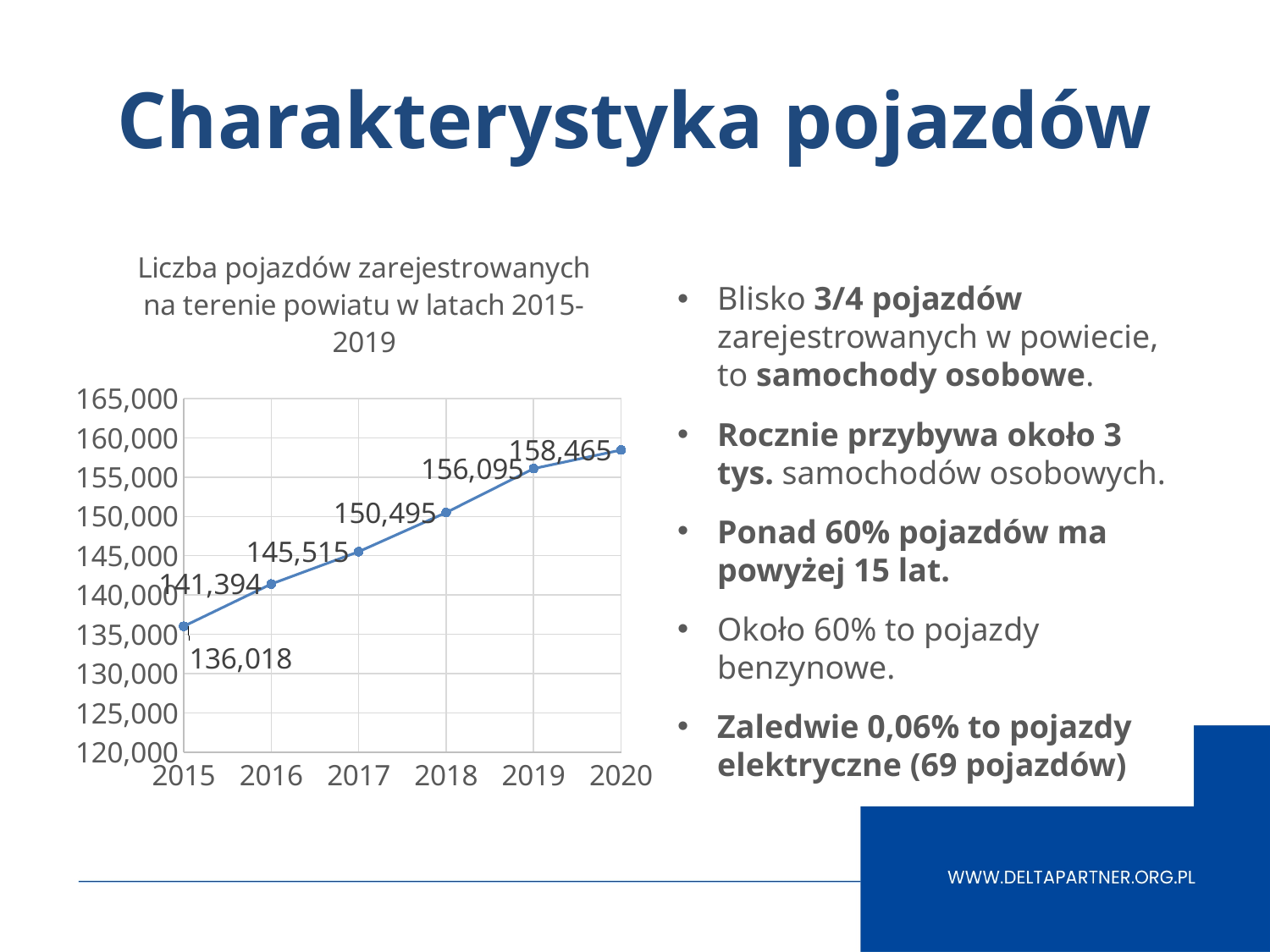
What is the difference between the values for 2020 and 2015? 22,447 Which year has the highest value in the chart? 2020 What is the value for 2018 in the chart? 150,495 Do the values rise or fall from 2015 to 2020? rise What is the value for 2015 in the chart? 136,018 What is the value for 2020 in the chart? 158,465 What kind of chart is shown on the slide? line chart Which is larger, the value for 2017 or the value for 2016? 2017 What is the difference between the values for 2019 and 2018? 5,600 Which year has the lowest value in the chart? 2015 Is the value for 2019 greater or less than 155,000? greater How many years are plotted in the chart? 6